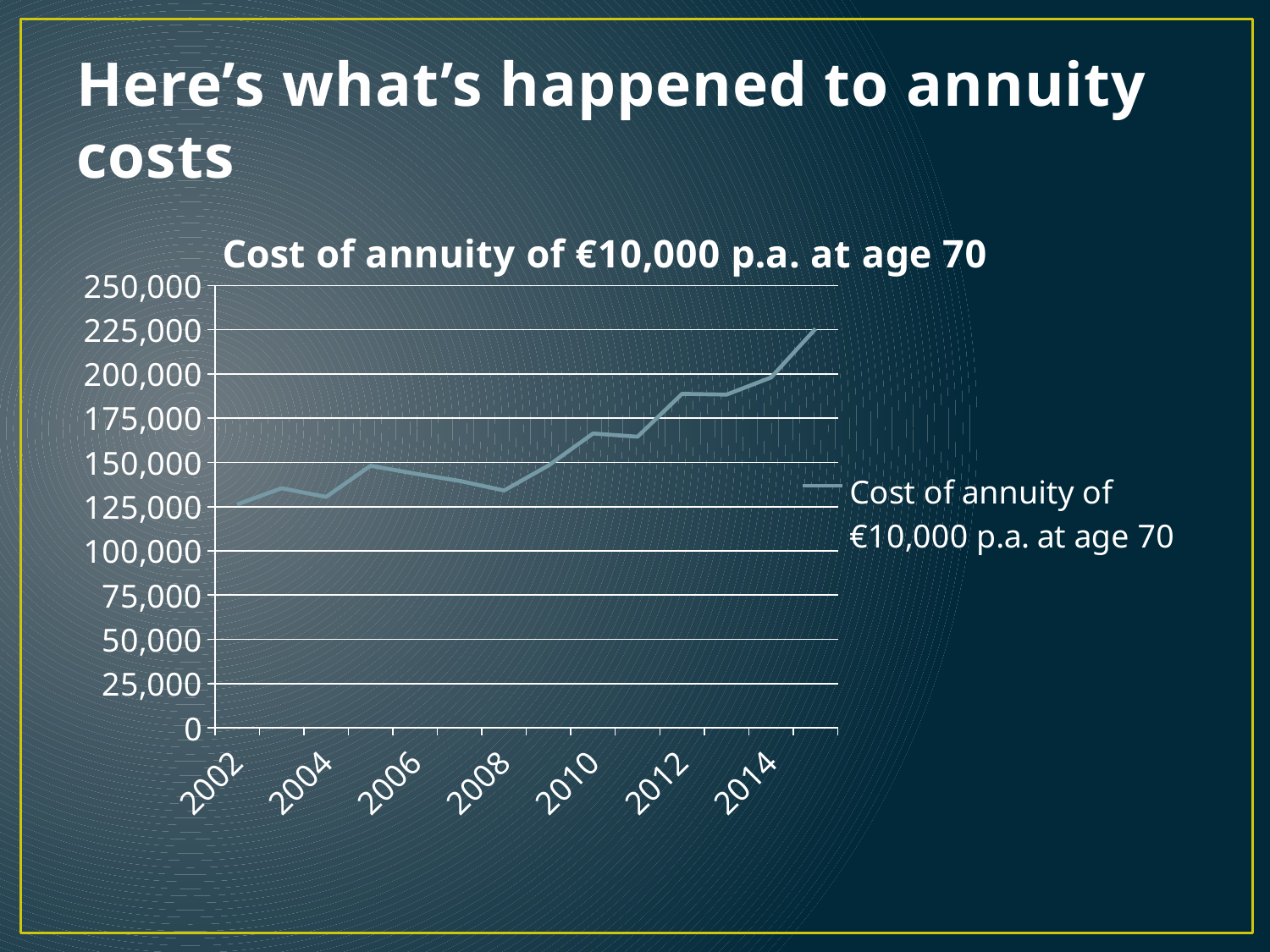
What kind of chart is shown on the slide? line chart What is the first year shown on the x axis? 2002 Which year has the larger value, 2008 or 2012? 2012 Is the value for 2002 greater or less than 150,000? less What is the title of the chart? Cost of annuity of €10,000 p.a. at age 70 In which year is the cost of annuity lowest? 2002 How many series does the legend list? 1 In which year is the cost of annuity highest? 2015 Is the value for 2014 greater or less than 175,000? greater Is the value for 2010 greater or less than 150,000? greater Overall, do the values rise or fall from 2002 to the end of the series? rise